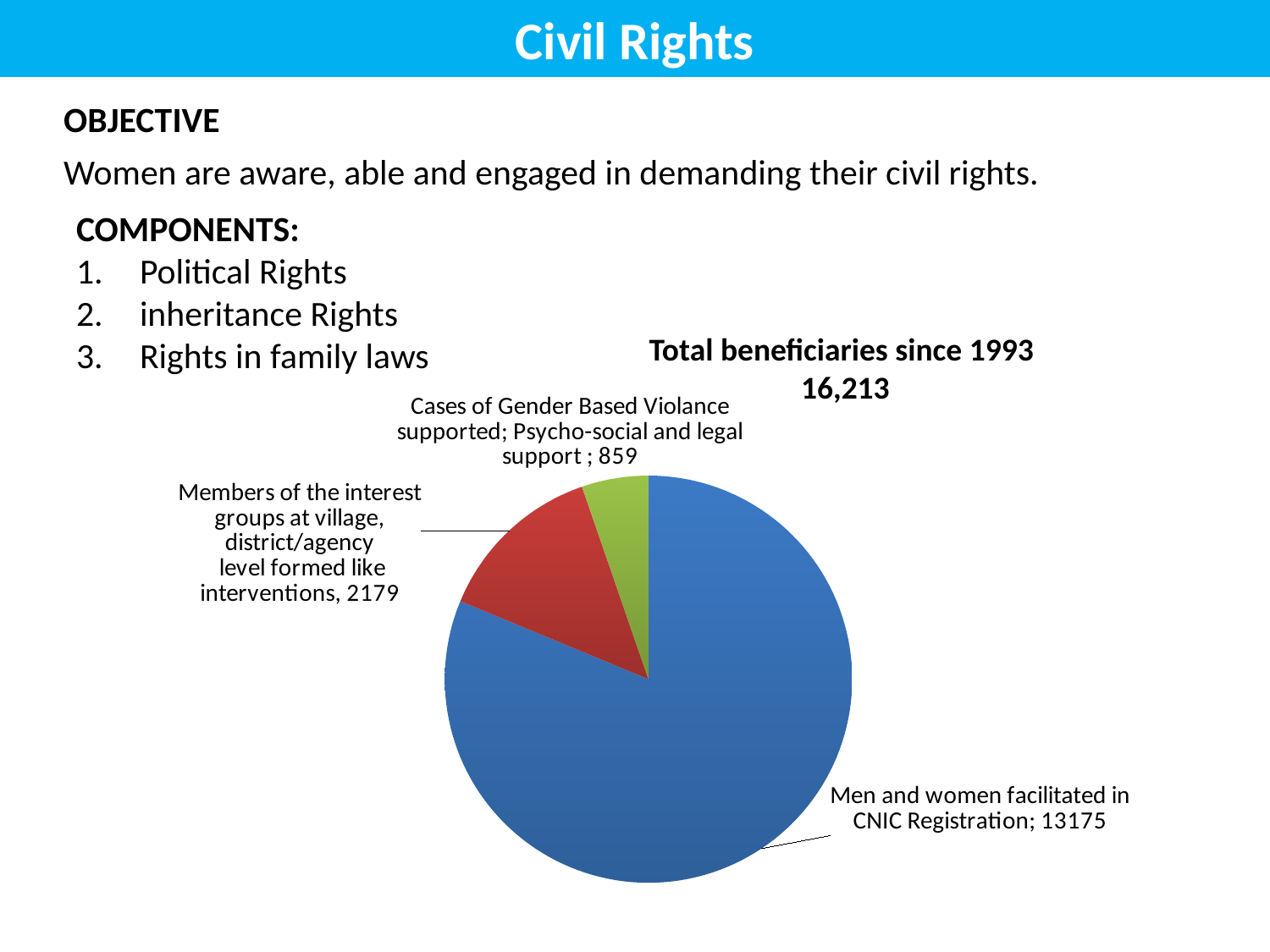
Which category has the largest slice of the pie? Men and women facilitated in CNIC Registration How many slices does the pie chart have? 3 What is the title of the chart? Total beneficiaries since 1993 16,213 What is the value for Men and women facilitated in CNIC Registration? 13175 What kind of chart is shown on the slide? Pie chart What is the difference between the value for Members of the interest groups and the value for Cases of Gender Based Violance supported? 1320 What is the total of all slices in the pie chart? 16,213 What is the value for Members of the interest groups at village, district/agency level formed like interventions? 2179 What is the difference between the value for CNIC Registration and the value for Members of the interest groups? 10996 What is the value for Cases of Gender Based Violance supported; Psycho-social and legal support? 859 Which is larger: the value for Members of the interest groups or the value for Cases of Gender Based Violance supported? Members of the interest groups Which category has the smallest slice of the pie? Cases of Gender Based Violance supported; Psycho-social and legal support